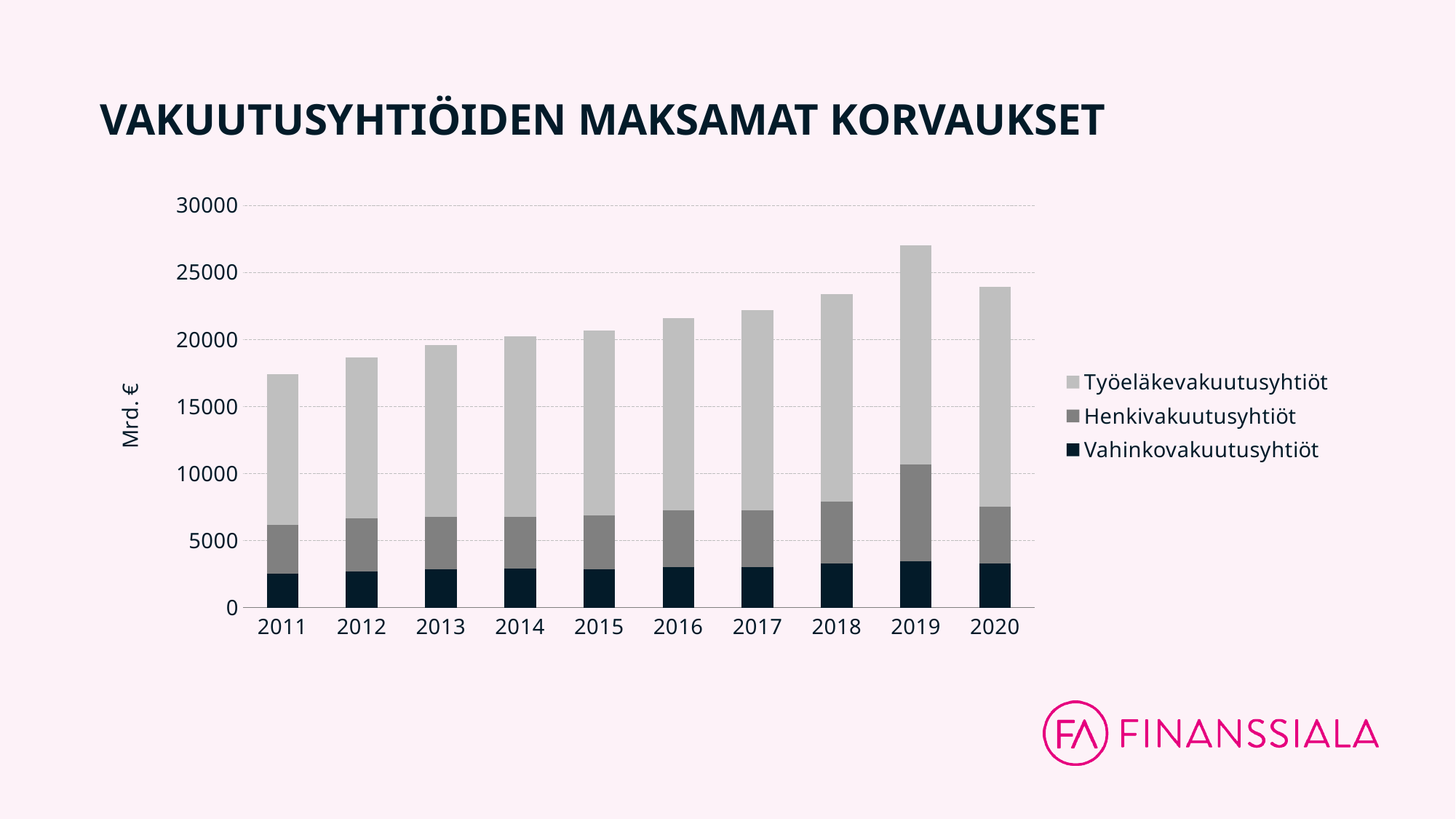
Which legend entry is shown in the darkest colour? Vahinkovakuutusyhtiöt What is the label on the y axis? Mrd. € What kind of chart is shown on the slide? Stacked bar chart How many years are shown on the x axis? 10 How many series does the legend list? 3 Is the total value for 2019 greater or less than 25000? greater Which year has the highest total bar? 2019 Is the total value for 2012 greater or less than 20000? less Do the total bar values rise or fall from 2011 to 2019? rise Is the total value for 2020 greater or less than 20000? greater Which is larger, the Henkivakuutusyhtiöt segment in 2019 or in 2018? 2019 Which year has the lowest total bar? 2011